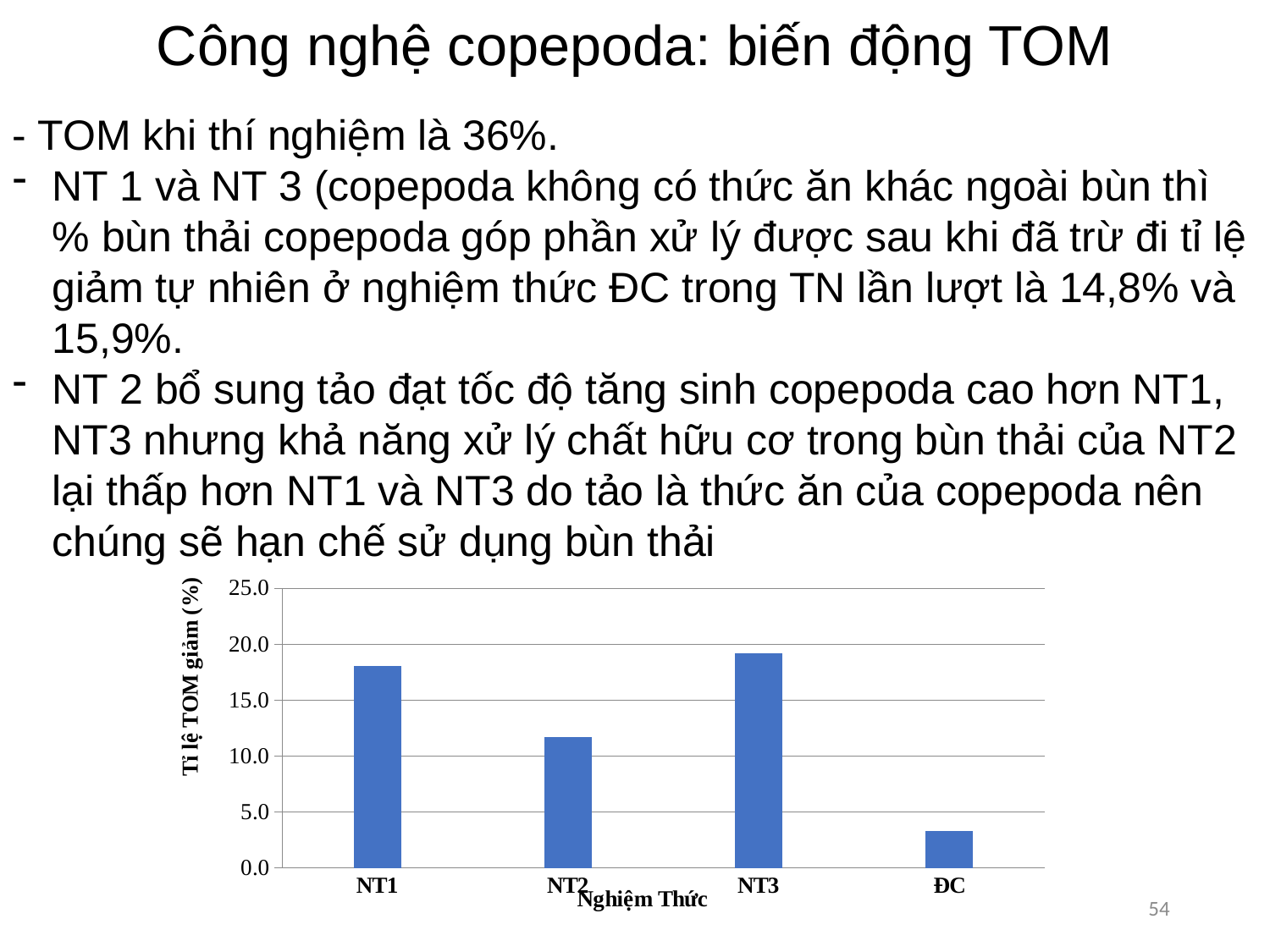
What kind of chart is shown on the slide? bar chart Is the value for NT1 greater or less than 15.0? greater What is the title of the horizontal axis of the chart? Nghiệm Thức Is the value for NT2 greater or less than 10.0? greater Is the value for NT3 greater or less than 20.0? less How many categories (nghiệm thức) are shown on the x axis of the chart? 4 Which category has the lowest Tỉ lệ TOM giảm (%) in the chart? ĐC What is the title of the vertical axis of the chart? Tỉ lệ TOM giảm (%) Which category has the highest Tỉ lệ TOM giảm (%) in the chart? NT3 Which has a larger Tỉ lệ TOM giảm (%), NT2 or ĐC? NT2